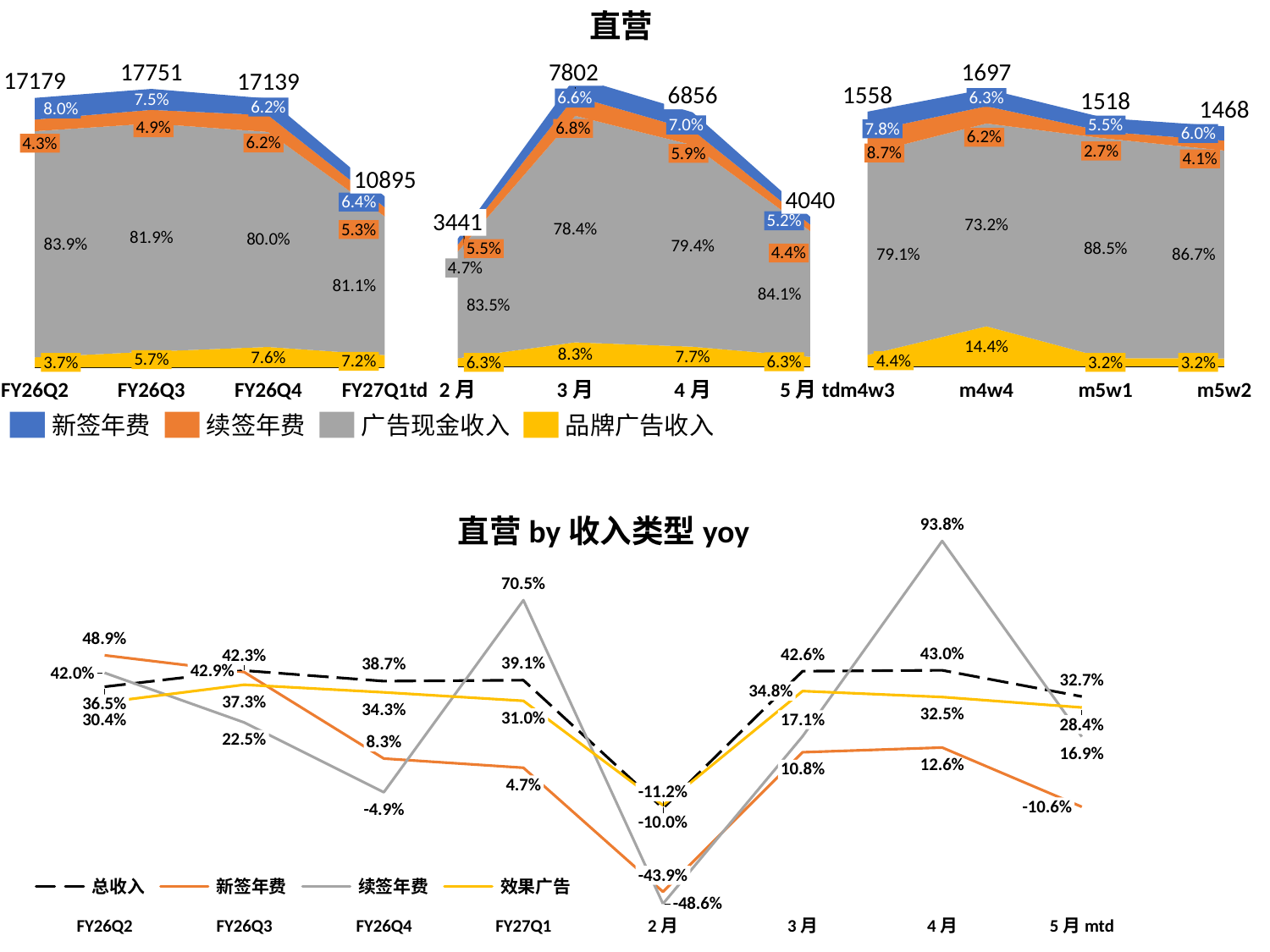
In the bottom chart titled 直营 by 收入类型 yoy, what is the highest value reached by 续签年费? 93.8% In the top chart titled 直营, what share does 品牌广告收入 have in m4w4? 14.4% In the top chart titled 直营, which is larger, the total for m4w3 or the total for m5w2? m4w3 In the bottom chart titled 直营 by 收入类型 yoy, what is the 新签年费 value for FY26Q2? 48.9% In the bottom chart titled 直营 by 收入类型 yoy, at which period is 总收入 lowest? 2月 In the top chart titled 直营, what share does 广告现金收入 have in FY26Q2? 83.9% What kind of chart is the bottom chart titled 直营 by 收入类型 yoy? line chart How many series does the legend of the top chart titled 直营 list? 4 In the bottom chart titled 直营 by 收入类型 yoy, what is the 总收入 value for 4月? 43.0% In the top chart titled 直营, what is the total value labeled for FY26Q3? 17751 In the top chart titled 直营, which month among 2月, 3月, 4月 and 5月 has the highest total? 3月 In the top chart titled 直营, what is the difference between the totals for 3月 and 4月? 946